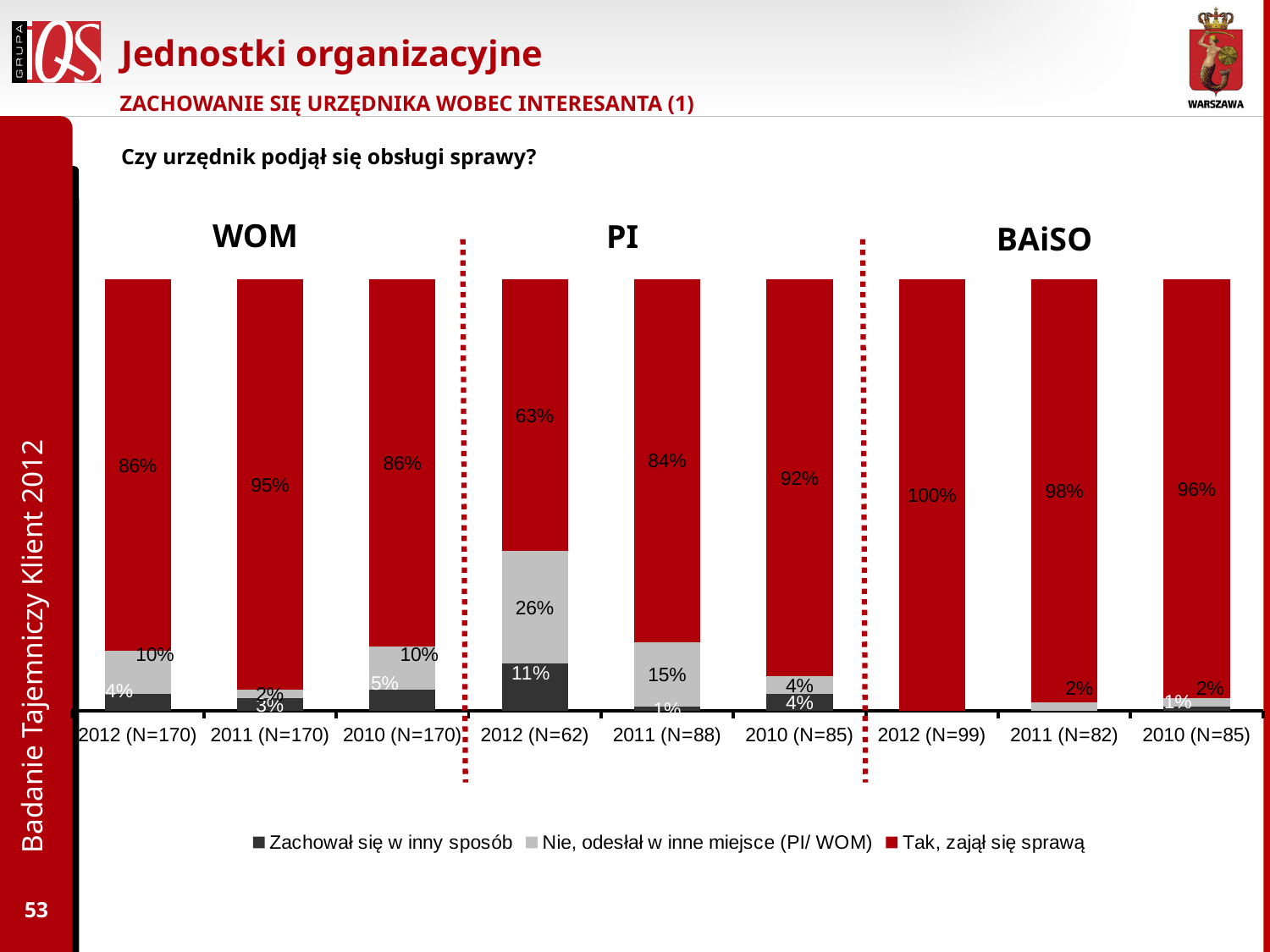
Which bar has the highest value for "Tak, zajął się sprawą"? 2012 (N=99) in BAiSO How many series does the legend list? 3 What is the value of "Tak, zajął się sprawą" for PI 2012 (N=62)? 63% What type of chart is shown on the slide? stacked bar chart What is the difference between the "Tak, zajął się sprawą" values for PI 2010 (N=85) and PI 2012 (N=62)? 29% What is the value of "Zachował się w inny sposób" for PI 2012 (N=62)? 11% What is the value of "Tak, zajął się sprawą" for WOM 2011 (N=170)? 95% Which colour represents "Tak, zajął się sprawą" in the chart? red Which is larger: the "Tak, zajął się sprawą" value for WOM 2012 (N=170) or for BAiSO 2010 (N=85)? BAiSO 2010 (N=85) Which bar has the lowest value for "Tak, zajął się sprawą"? 2012 (N=62) in PI How many bars are plotted in the chart? 9 What is the value of "Nie, odesłał w inne miejsce (PI/ WOM)" for PI 2012 (N=62)? 26%